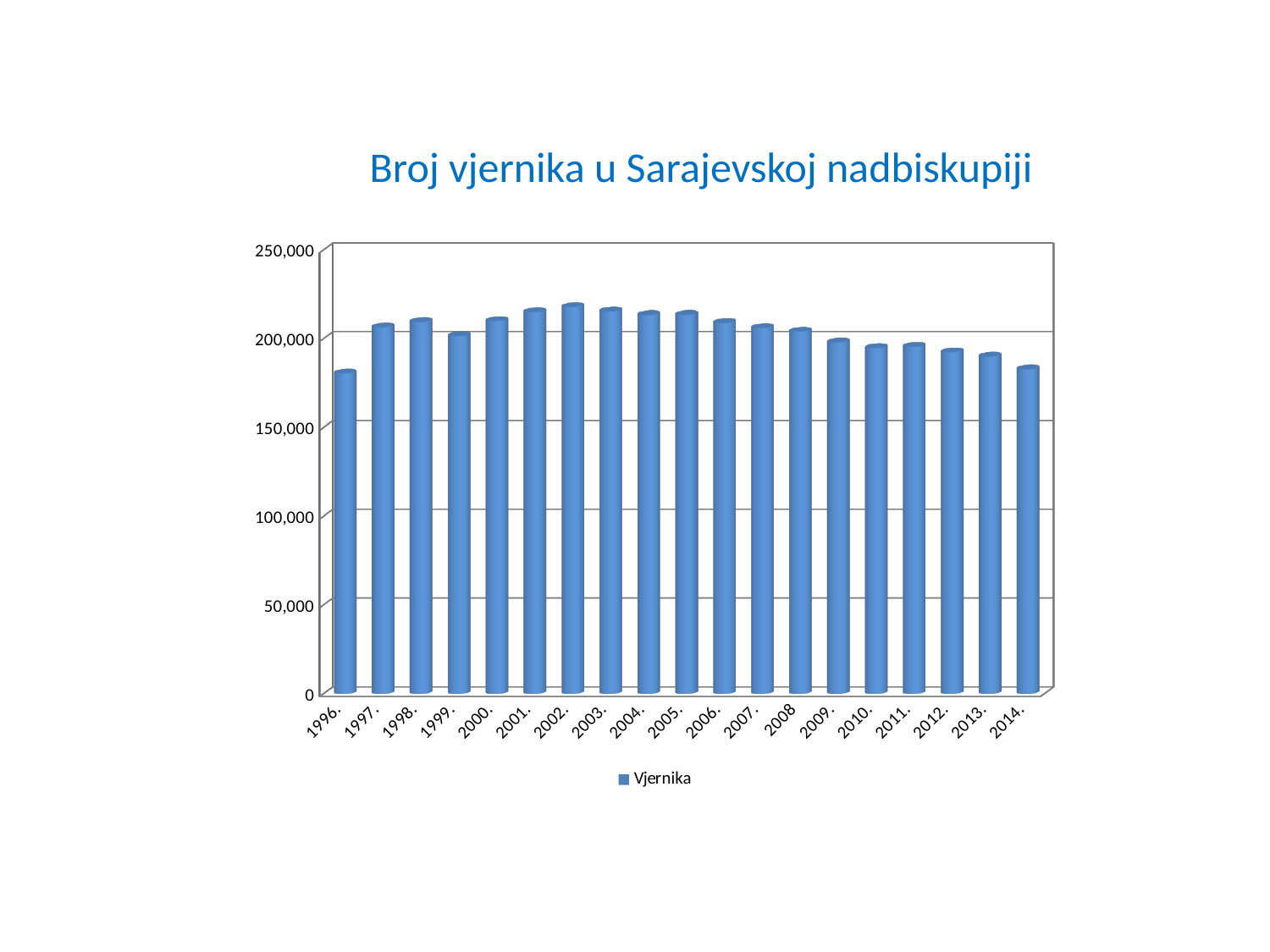
How many series does the legend list? 1 Is the value for 2010. greater or less than 200,000? less Do the values rise or fall from 2002. to 2014.? fall Is the value for 2002. greater or less than 200,000? greater How many years (categories) are plotted on the x axis? 19 Is the value for 2014. greater or less than 200,000? less Which year has the larger value, 2002. or 2014.? 2002. Which year has the larger value, 1996. or 2001.? 2001. What is the title of the chart? Broj vjernika u Sarajevskoj nadbiskupiji What is the name of the series shown in the legend? Vjernika What kind of chart is shown on the slide? bar chart